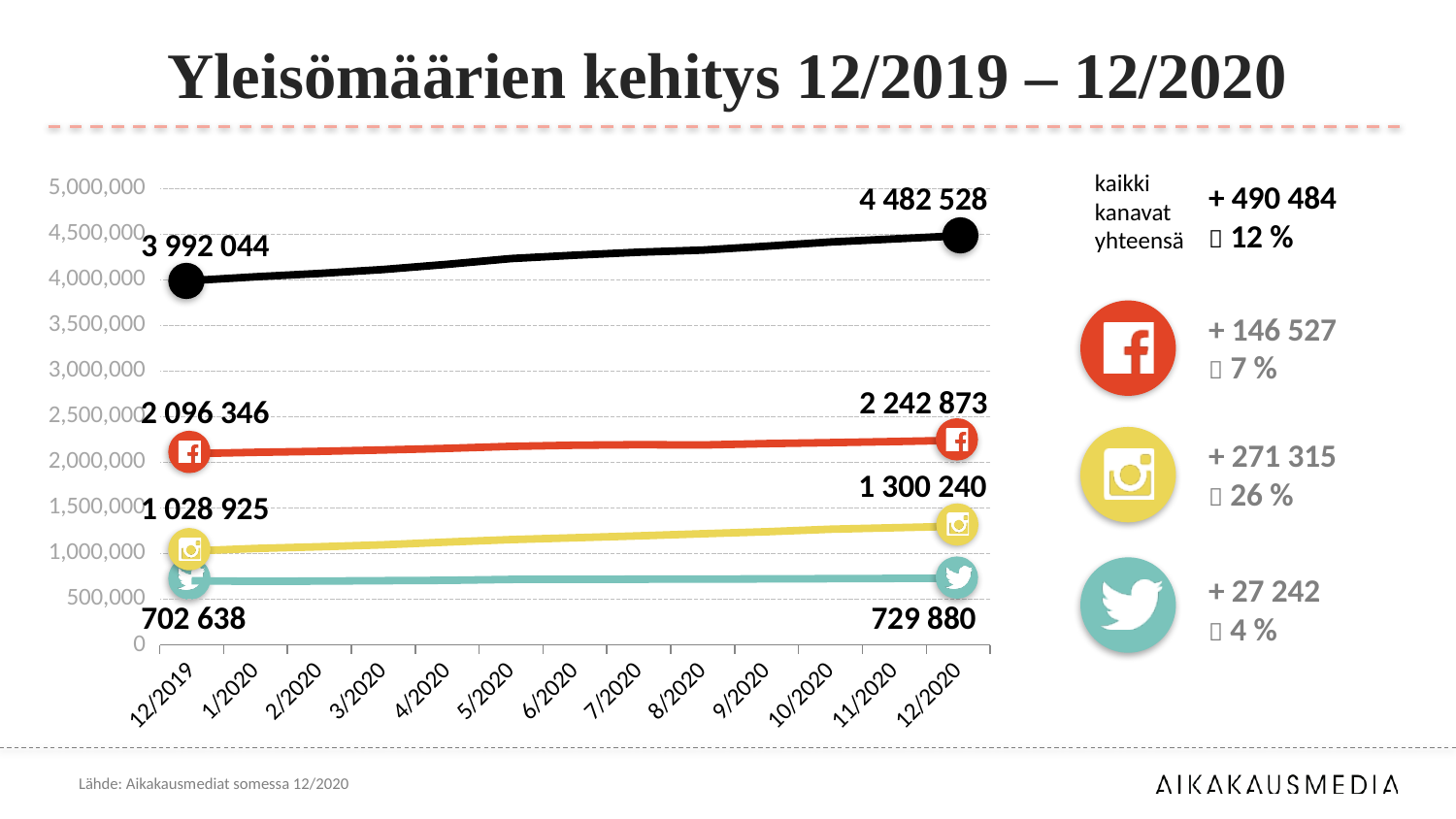
What is the Facebook value at 12/2020? 2 242 873 By how much did the Facebook value increase from 12/2019 to 12/2020? 146 527 What is the Twitter value at 12/2020? 729 880 What is the value of the black line (all channels total) at 12/2019? 3 992 044 Does the Instagram line rise or fall from 12/2019 to 12/2020? rise By how much did the Instagram value increase from 12/2019 to 12/2020? 271 315 How many months are shown on the x axis? 13 What type of chart is shown on the slide? line chart What is the Instagram value at 12/2019? 1 028 925 What is the value of the black line (all channels total) at 12/2020? 4 482 528 Which channel has the lowest value at 12/2020: Facebook, Instagram or Twitter? Twitter Which is larger at 12/2019, the Facebook value or the Instagram value? Facebook